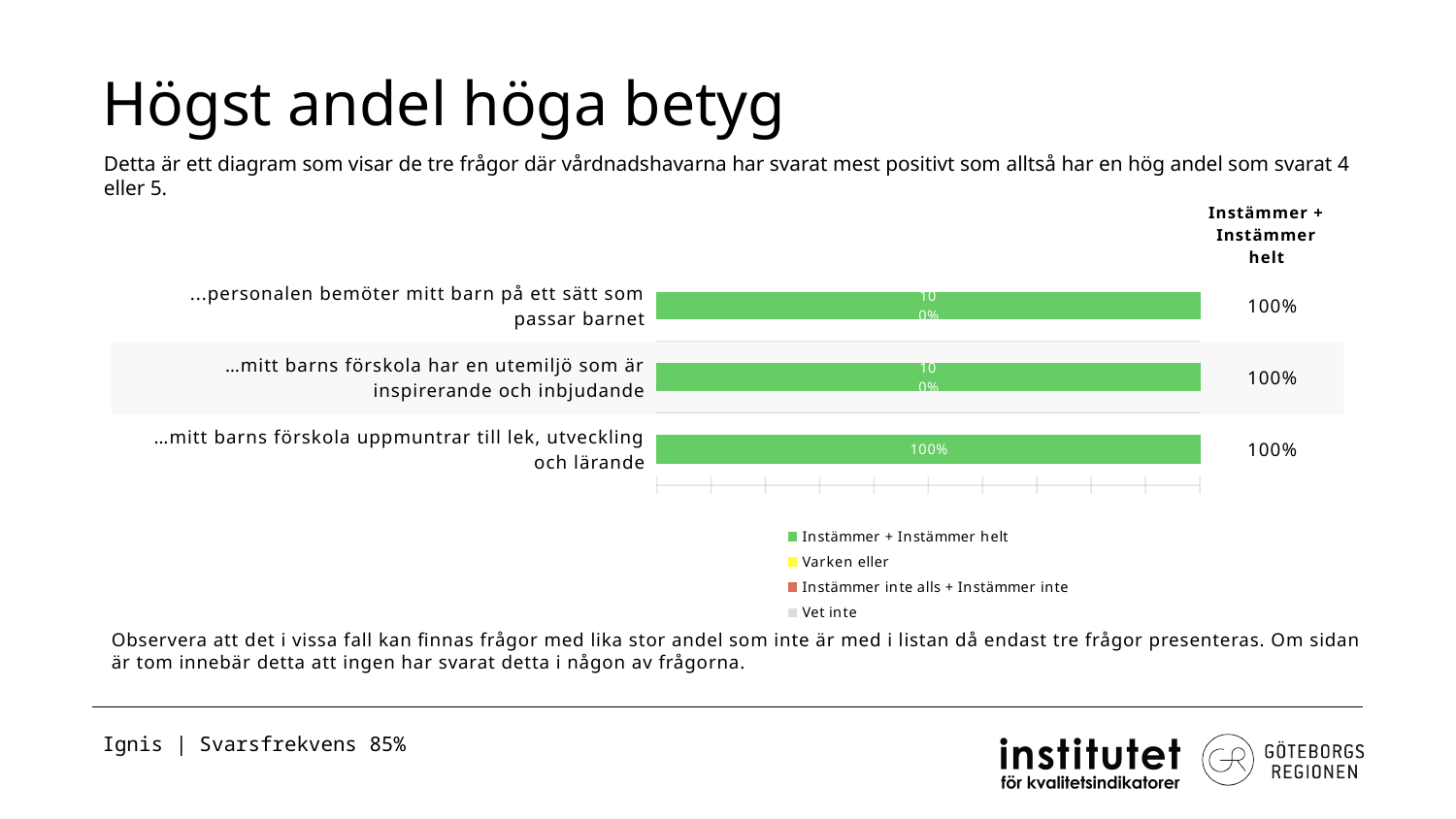
What is the 'Instämmer + Instämmer helt' value for '…mitt barns förskola har en utemiljö som är inspirerande och inbjudande'? 100% What is the title of the slide containing the chart? Högst andel höga betyg How many categories (questions) are plotted in the chart? 3 What is the 'Instämmer + Instämmer helt' value for '…personalen bemöter mitt barn på ett sätt som passar barnet'? 100% What is the total of the stacked bar for '…mitt barns förskola har en utemiljö som är inspirerande och inbjudande'? 100% What is the difference between the 'Instämmer + Instämmer helt' values for '…personalen bemöter mitt barn på ett sätt som passar barnet' and '…mitt barns förskola uppmuntrar till lek, utveckling och lärande'? 0% What is the 'Instämmer + Instämmer helt' value for '…mitt barns förskola uppmuntrar till lek, utveckling och lärande'? 100% Which legend entry is shown in green? Instämmer + Instämmer helt How many series does the chart legend list? 4 What kind of chart is shown on the slide? bar chart